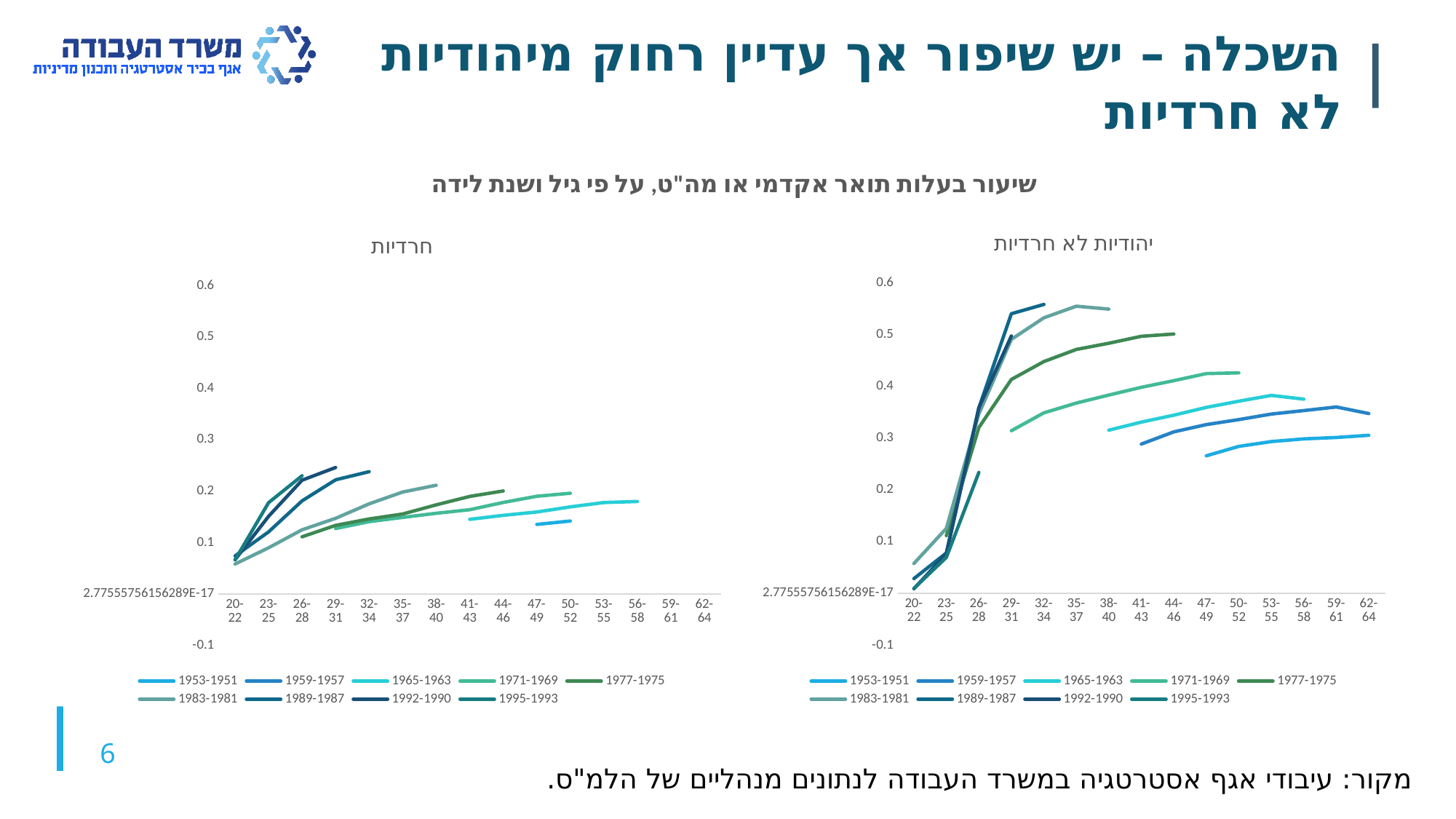
In the left chart (חרדיות), is the value of the 1953-1951 series at age 47-49 greater or less than 0.1? greater In the left chart (חרדיות), is the value of the 1965-1963 series at age 56-58 greater or less than 0.2? less How many age-group categories are shown on the x axis of the left chart (חרדיות)? 15 In the right chart (יהודיות לא חרדיות), is the value of the 1971-1969 series at age 50-52 greater or less than 0.4? greater What is the title of the right chart? יהודיות לא חרדיות How many series does the legend of the right chart (יהודיות לא חרדיות) list? 9 What kind of chart is the left chart titled חרדיות? line chart